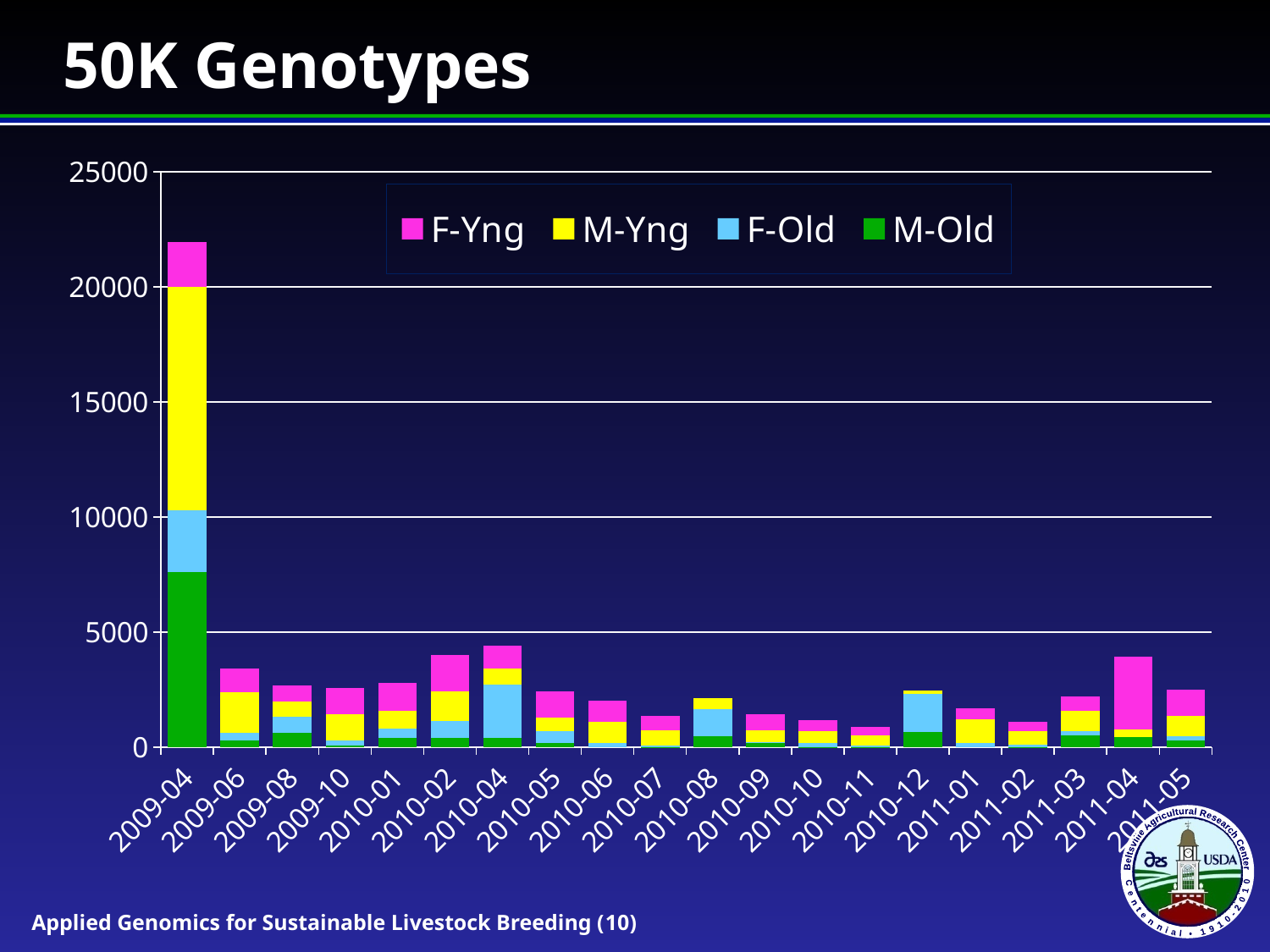
Which category has the highest total bar? 2009-04 What is the title of the chart? 50K Genotypes Is the total for 2009-04 greater or less than 20000? greater Which colour represents the M-Old series in the legend? Green How many categories are shown on the x axis? 20 Which has the larger total bar, 2011-04 or 2011-05? 2011-04 Which has the larger total bar, 2009-04 or 2009-06? 2009-04 How many series does the legend list? 4 What kind of chart is shown on the slide? Stacked bar chart Which has the larger total bar, 2010-02 or 2010-06? 2010-02 Is the total for 2011-04 greater or less than 5000? less Is the total for 2010-04 greater or less than 5000? less